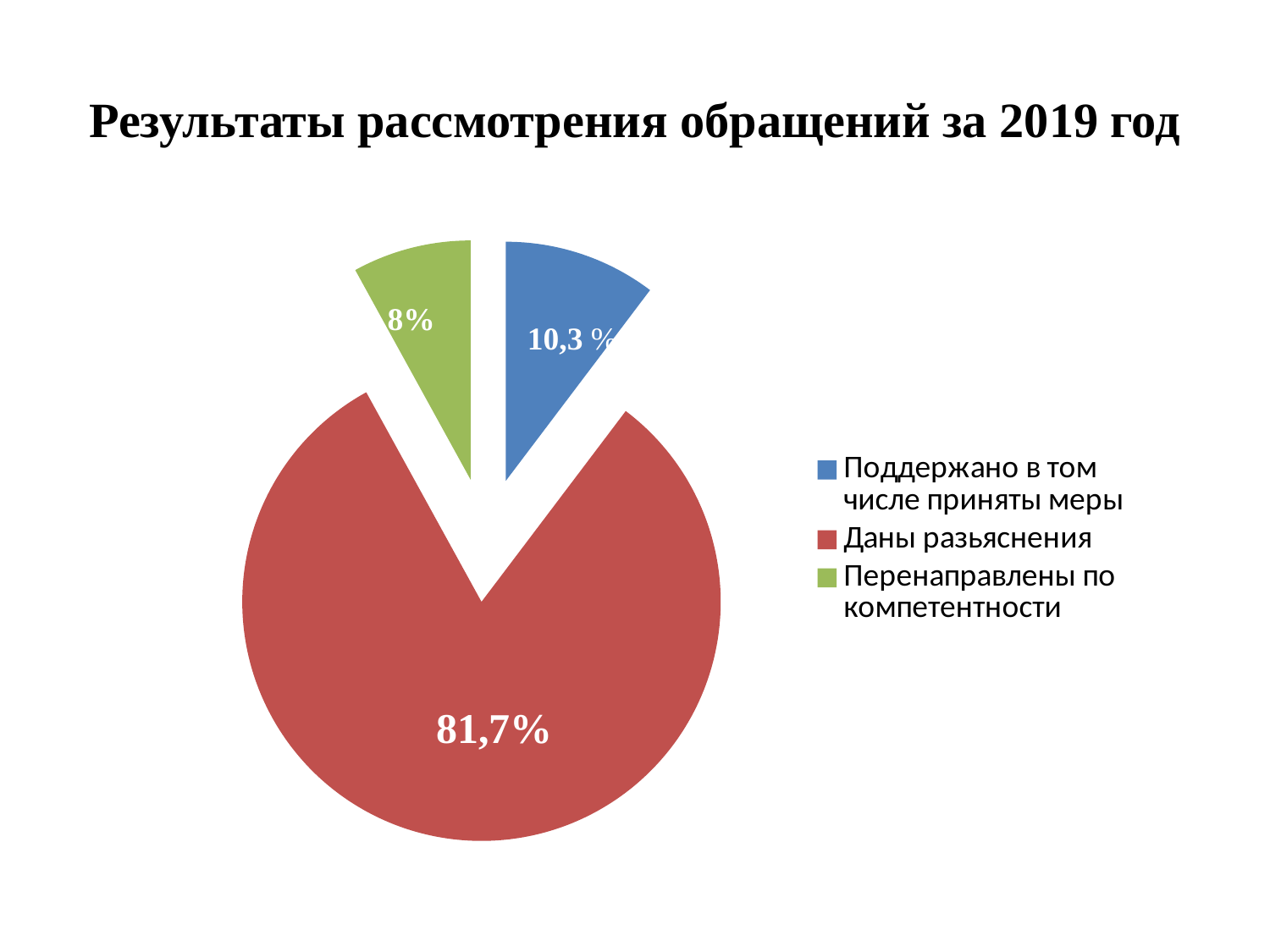
Which category has the largest slice of the pie? Даны разьяснения What is the difference between the shares for "Даны разьяснения" and "Поддержано в том числе приняты меры"? 71,4% How many slices does the pie chart have? 3 What share of the pie is labelled for "Даны разьяснения"? 81,7% What colour is the slice for "Даны разьяснения"? red What value is shown for "Поддержано в том числе приняты меры"? 10,3 % What kind of chart is shown on the slide? pie chart What value is shown for "Перенаправлены по компетентности"? 8% Which is larger: "Поддержано в том числе приняты меры" or "Перенаправлены по компетентности"? Поддержано в том числе приняты меры How many entries does the legend list? 3 What is the title of the chart? Результаты рассмотрения обращений за 2019 год Which category has the smallest slice of the pie? Перенаправлены по компетентности